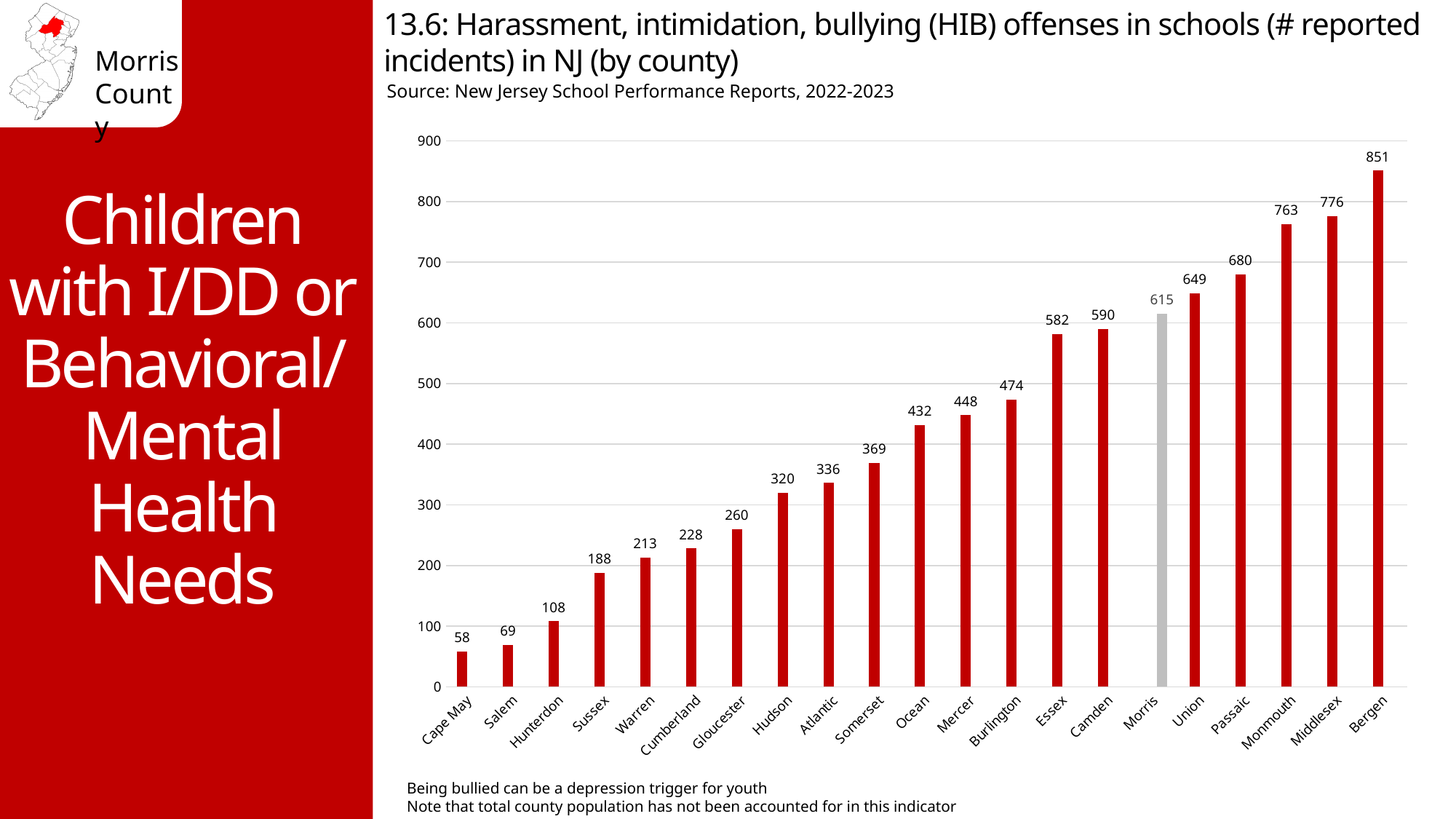
Which county has the highest number of reported HIB incidents? Bergen What is the difference in reported HIB incidents between Bergen and Morris counties? 236 What type of chart is used on this slide? Bar chart What is the number of reported HIB incidents for Morris County? 615 How many reported HIB incidents does Bergen County have? 851 Is the value for Passaic greater or less than 700? less Which county has the lowest number of reported HIB incidents? Cape May Do the values rise or fall moving from left to right along the x axis? Rise What is the value shown for Hudson County? 320 Which county has more reported HIB incidents, Essex or Camden? Camden How many counties are shown on the chart? 21 Which county's bar is shown in grey rather than red? Morris